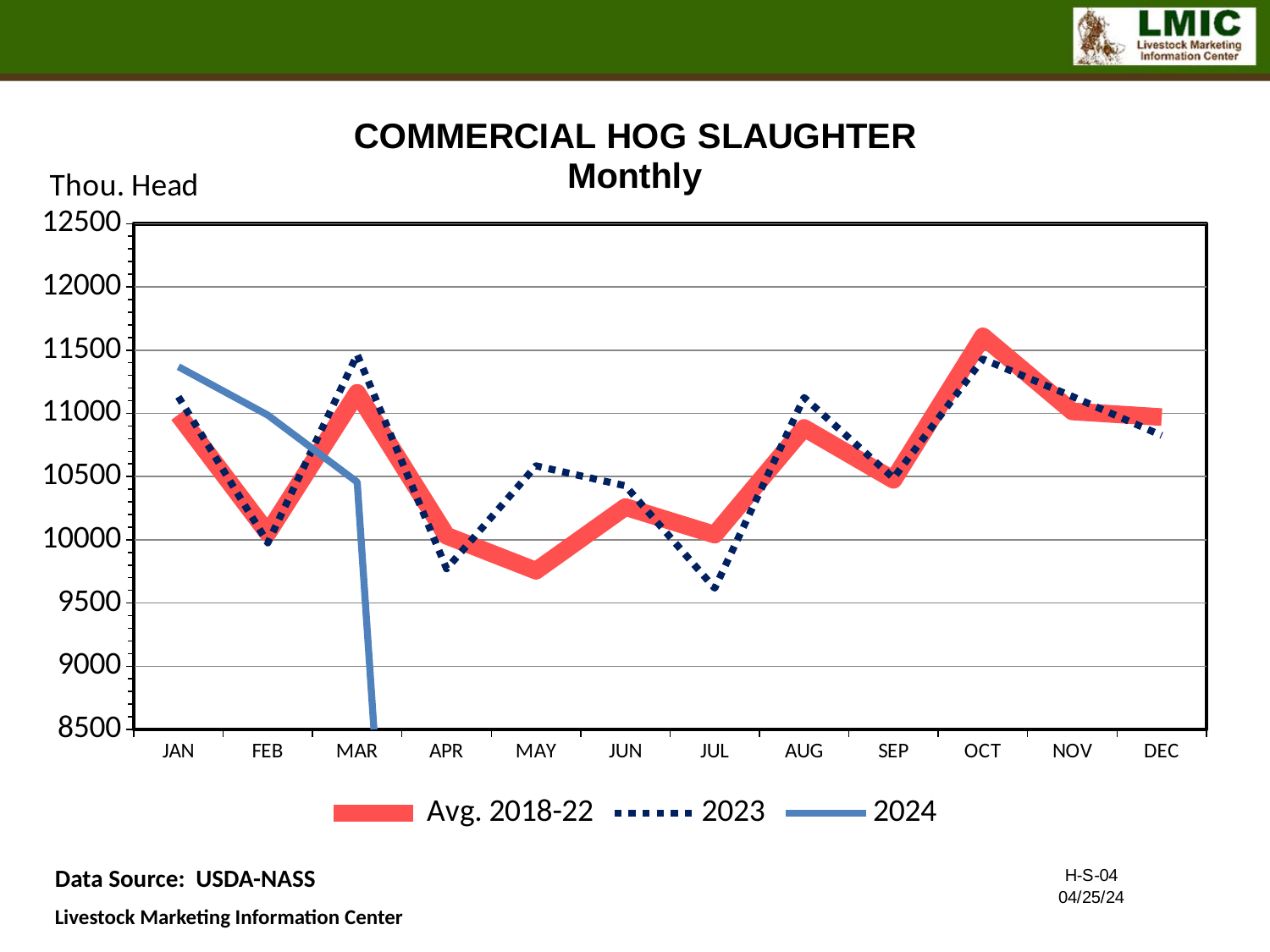
How many months are shown along the x axis? 12 Is the Avg. 2018-22 value for OCT greater or less than 11500? greater What kind of chart is shown on the slide? line chart What unit is shown on the y axis label? Thou. Head Is the 2024 value for JAN greater or less than 11000? greater In which month is the Avg. 2018-22 series highest? OCT Is the Avg. 2018-22 value for MAY greater or less than 10000? less Does the 2024 series rise or fall from JAN to MAR? fall In which month is the Avg. 2018-22 series lowest? MAY In FEB, which series is higher: 2023 or 2024? 2024 How many series does the legend list? 3